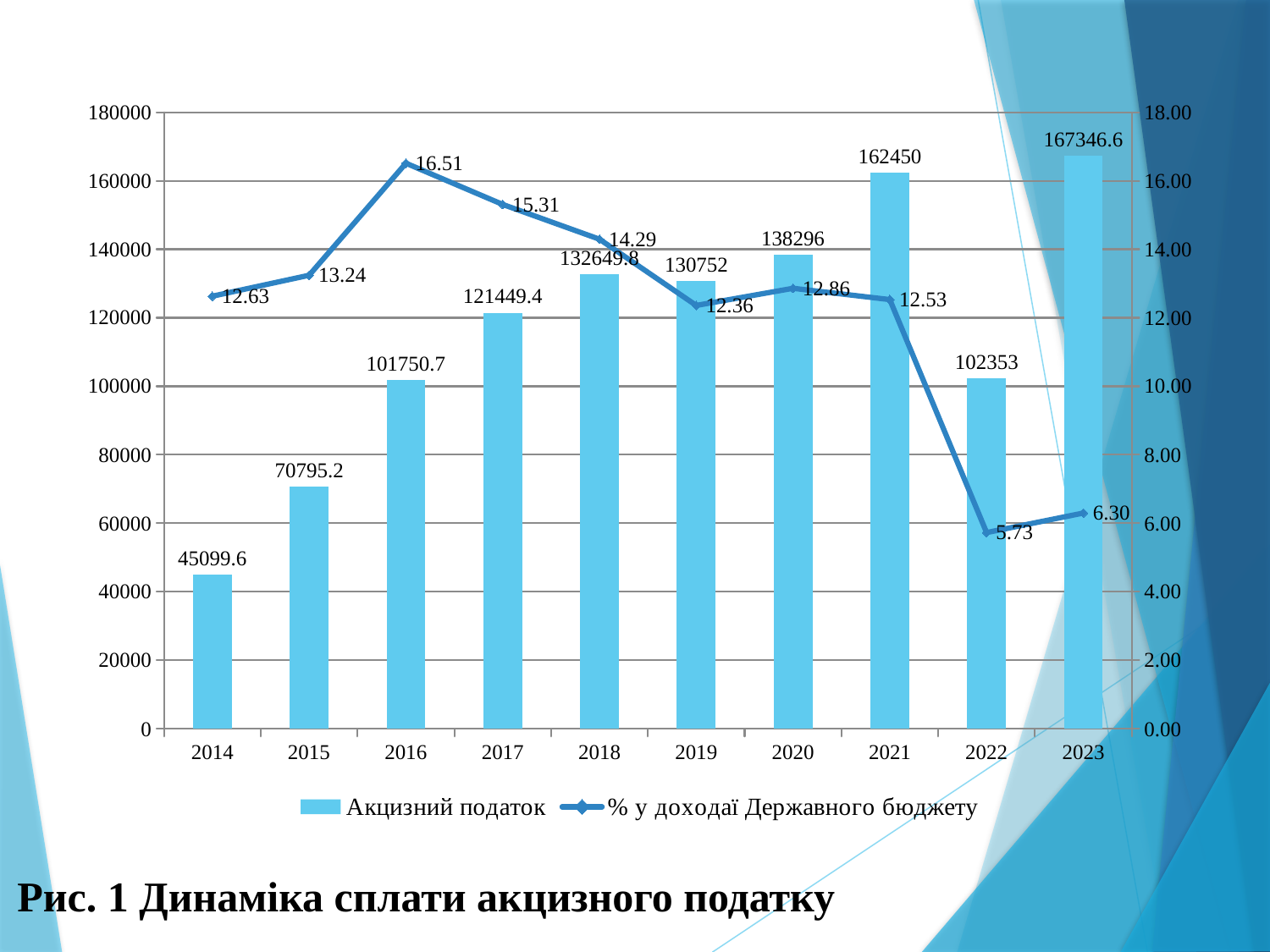
Which year has the highest value of Акцизний податок? 2023 What kind of chart is used for the Акцизний податок series? bar chart What is the difference between the Акцизний податок values for 2023 and 2022? 64993.6 What is the value of Акцизний податок for 2014? 45099.6 How many years are shown on the x axis? 10 How many series does the legend list? 2 Which is larger, the Акцизний податок value for 2018 or for 2019? 2018 Does the % у доходаї Державного бюджету value rise or fall from 2021 to 2022? fall What is the caption of the figure below the chart? Рис. 1 Динаміка сплати акцизного податку What is the value of Акцизний податок for 2021? 162450 Which year has the lowest value of % у доходаї Державного бюджету? 2022 What is the value of % у доходаї Державного бюджету for 2016? 16.51